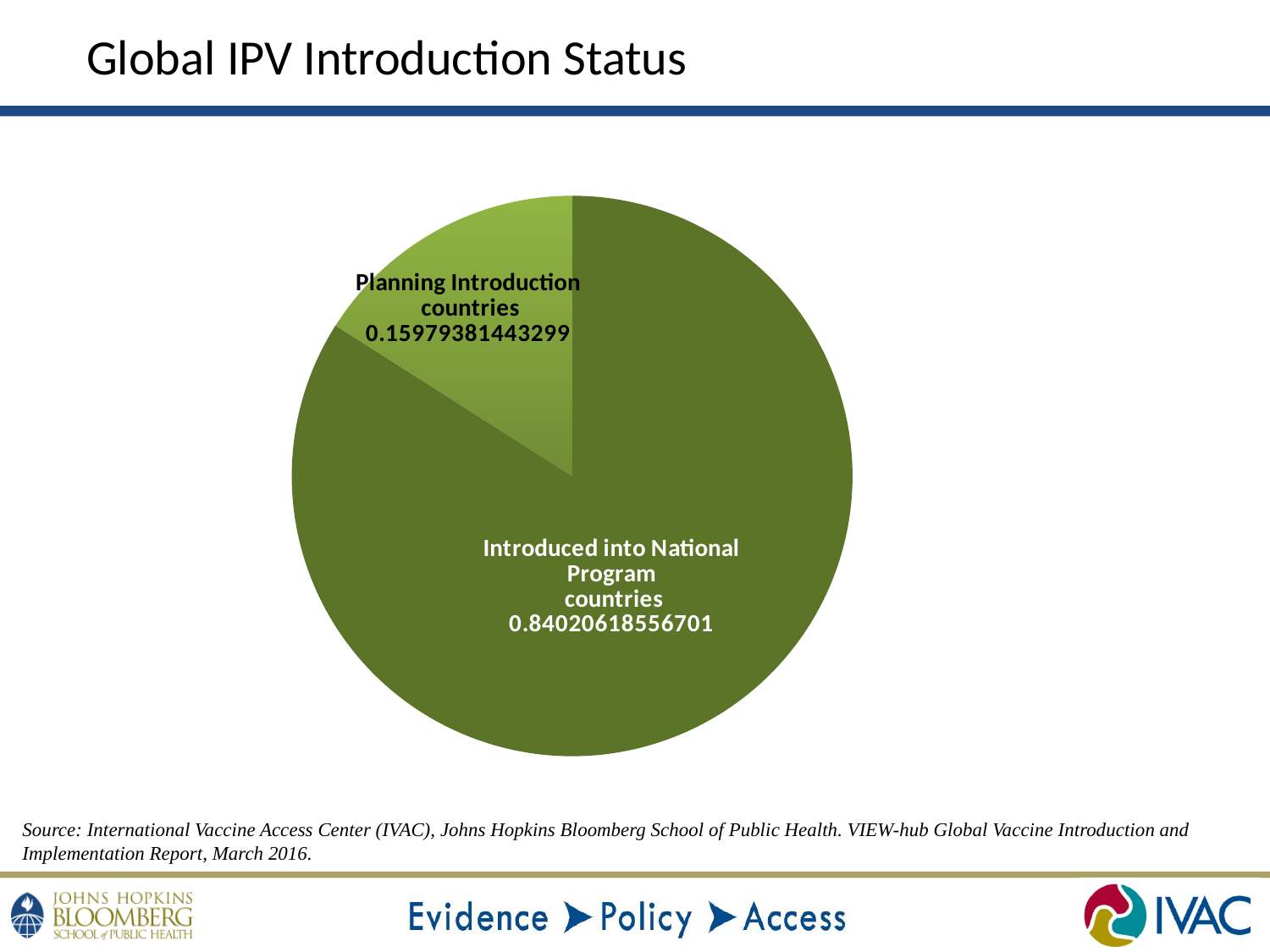
Which slice is shown in the lighter green colour? Planning Introduction countries Which slice of the pie is the largest? Introduced into National Program countries Which slice of the pie is the smallest? Planning Introduction countries What is the value shown for the 'Introduced into National Program countries' slice? 0.84020618556701 What is the value shown for the 'Planning Introduction countries' slice? 0.15979381443299 What is the title of the slide containing the pie chart? Global IPV Introduction Status What kind of chart is shown on the slide? pie chart How many slices does the pie chart have? 2 Which is larger: the 'Introduced into National Program countries' slice or the 'Planning Introduction countries' slice? Introduced into National Program countries